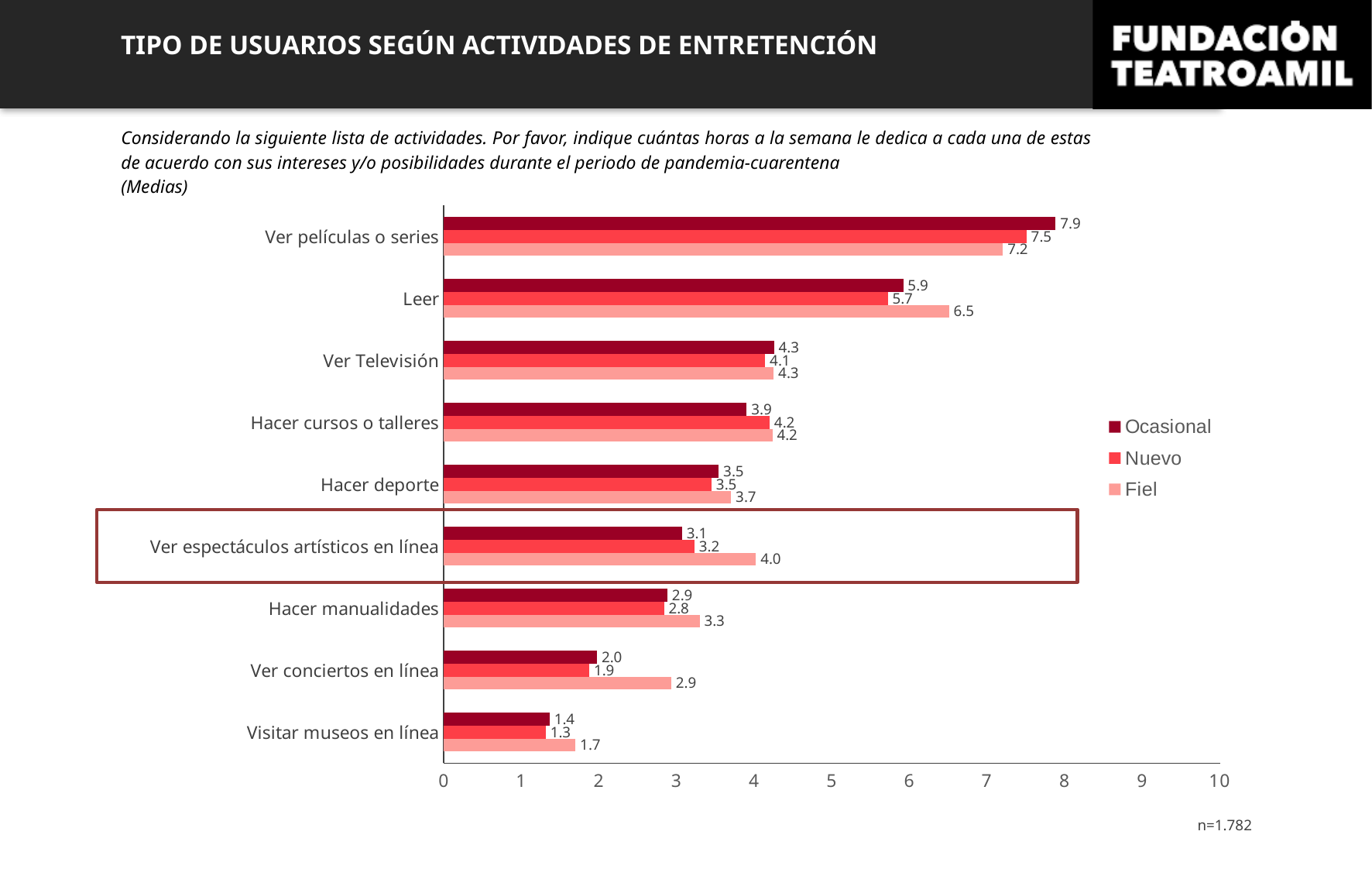
How many activities are shown on the chart? 9 How many series does the legend list? 3 What is the value for Ocasional users for 'Ver películas o series'? 7.9 What is the difference between the Fiel and Ocasional values for 'Ver conciertos en línea'? 0.9 For 'Leer', which is larger: the Fiel value or the Ocasional value? Fiel Which activity has the highest value for Fiel users? Ver películas o series Which activity has the lowest value for Nuevo users? Visitar museos en línea What is the value for Nuevo users for 'Leer'? 5.7 What kind of chart is shown on the slide? Bar chart What is the sample size noted on the slide? n=1.782 What is the value for Fiel users for 'Ver espectáculos artísticos en línea'? 4.0 Which activity is highlighted with a box on the chart? Ver espectáculos artísticos en línea